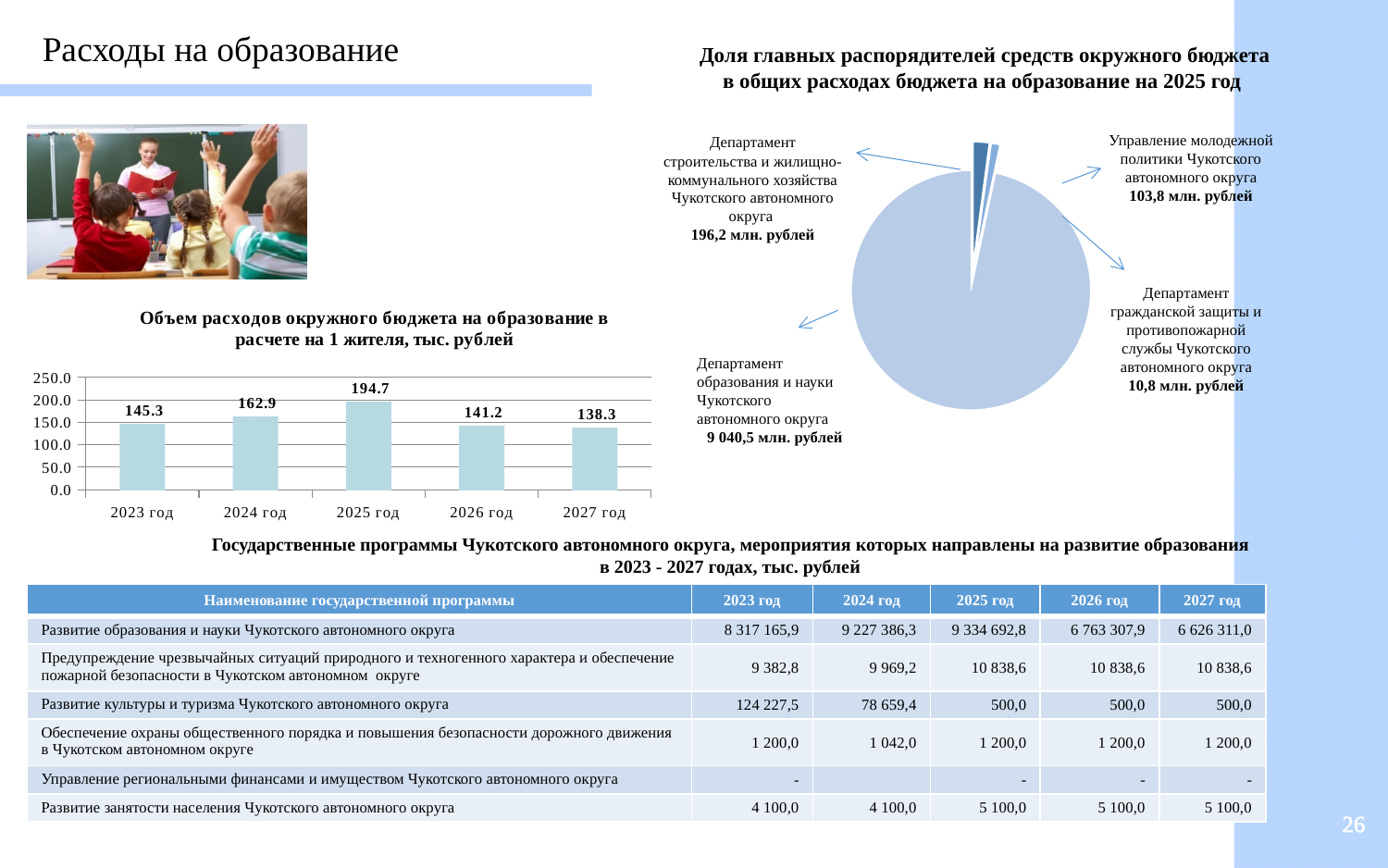
In the bar chart 'Объем расходов окружного бюджета на образование в расчете на 1 жителя, тыс. рублей', how many years are shown? 5 In the bar chart 'Объем расходов окружного бюджета на образование в расчете на 1 жителя, тыс. рублей', which year has the highest value? 2025 год In the bar chart 'Объем расходов окружного бюджета на образование в расчете на 1 жителя, тыс. рублей', what is the value for 2025 год? 194.7 In the pie chart 'Доля главных распорядителей средств окружного бюджета в общих расходах бюджета на образование на 2025 год', what is the value for Департамент образования и науки Чукотского автономного округа? 9 040,5 млн. рублей In the bar chart 'Объем расходов окружного бюджета на образование в расчете на 1 жителя, тыс. рублей', which is larger: the value for 2024 год or 2026 год? 2024 год In the bar chart 'Объем расходов окружного бюджета на образование в расчете на 1 жителя, тыс. рублей', what is the value for 2023 год? 145.3 In the pie chart 'Доля главных распорядителей средств окружного бюджета в общих расходах бюджета на образование на 2025 год', which distributor has the smallest slice? Департамент гражданской защиты и противопожарной службы Чукотского автономного округа What kind of chart is 'Объем расходов окружного бюджета на образование в расчете на 1 жителя, тыс. рублей'? bar chart In the pie chart 'Доля главных распорядителей средств окружного бюджета в общих расходах бюджета на образование на 2025 год', what is the value for Управление молодежной политики Чукотского автономного округа? 103,8 млн. рублей In the bar chart 'Объем расходов окружного бюджета на образование в расчете на 1 жителя, тыс. рублей', which year has the lowest value? 2027 год In the bar chart 'Объем расходов окружного бюджета на образование в расчете на 1 жителя, тыс. рублей', do the values rise or fall from 2025 год to 2027 год? fall In the bar chart 'Объем расходов окружного бюджета на образование в расчете на 1 жителя, тыс. рублей', what is the difference between the values for 2025 год and 2024 год? 31.8